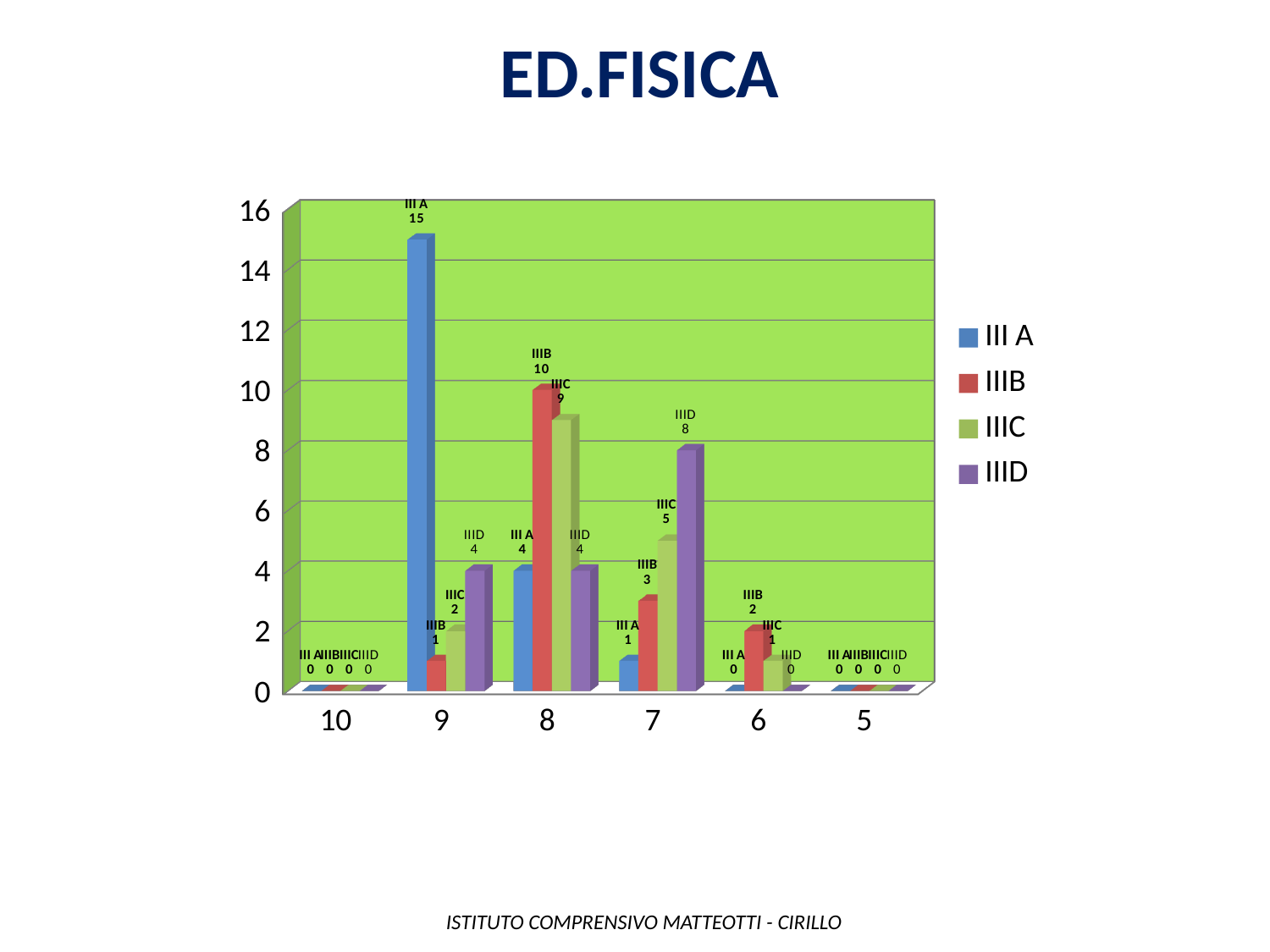
Which series has the lowest value at grade 8? III A and IIID (both 4) Which is larger at grade 7: the value for IIIC or the value for IIID? IIID What is the total of all four series at grade 7? 17 What is the value for III A at grade 9? 15 How many series does the legend list? 4 What is the value for IIIB at grade 8? 10 What is the value for IIIC at grade 6? 1 How many grade categories are shown on the x axis? 6 What kind of chart is shown on the slide? Bar chart What is the difference between the IIIB and IIIC values at grade 8? 1 What is the value for IIID at grade 7? 8 Which series has the highest value at grade 9? III A